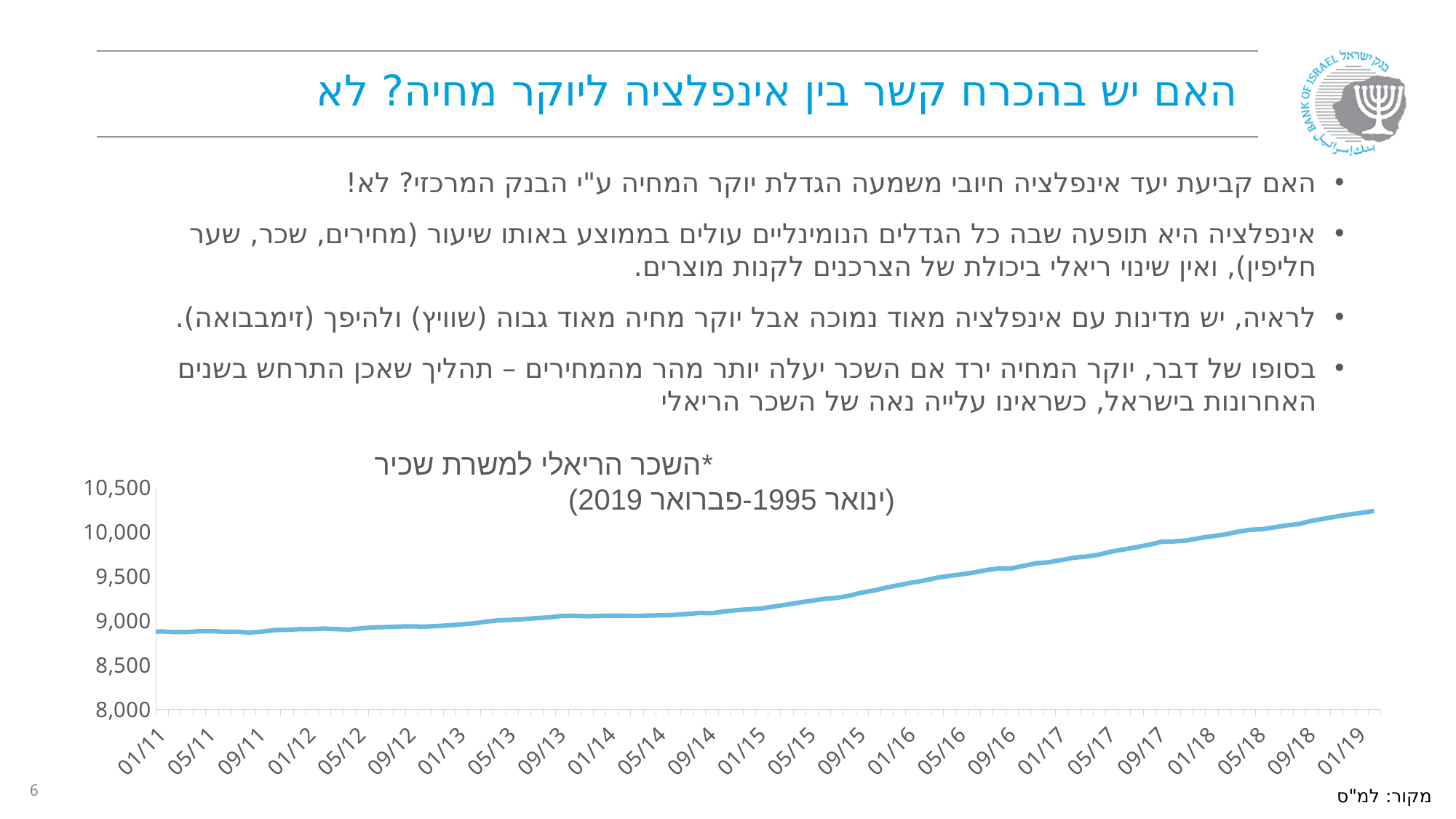
Is the value at 01/19 greater or less than 10,000? greater What source is cited for the chart at the bottom of the slide? למ"ס Is the value at 01/11 greater or less than 9,000? less Is the value at 01/15 greater or less than 9,000? greater Which is larger, the value at 01/12 or the value at 01/16? 01/16 At which x-axis label does the line reach its highest value? 01/19 What kind of chart is shown on the slide? line chart What is the highest tick value shown on the y axis? 10,500 Does the real wage line generally rise or fall from 01/11 to 01/19? rise How many date labels are shown on the x axis? 25